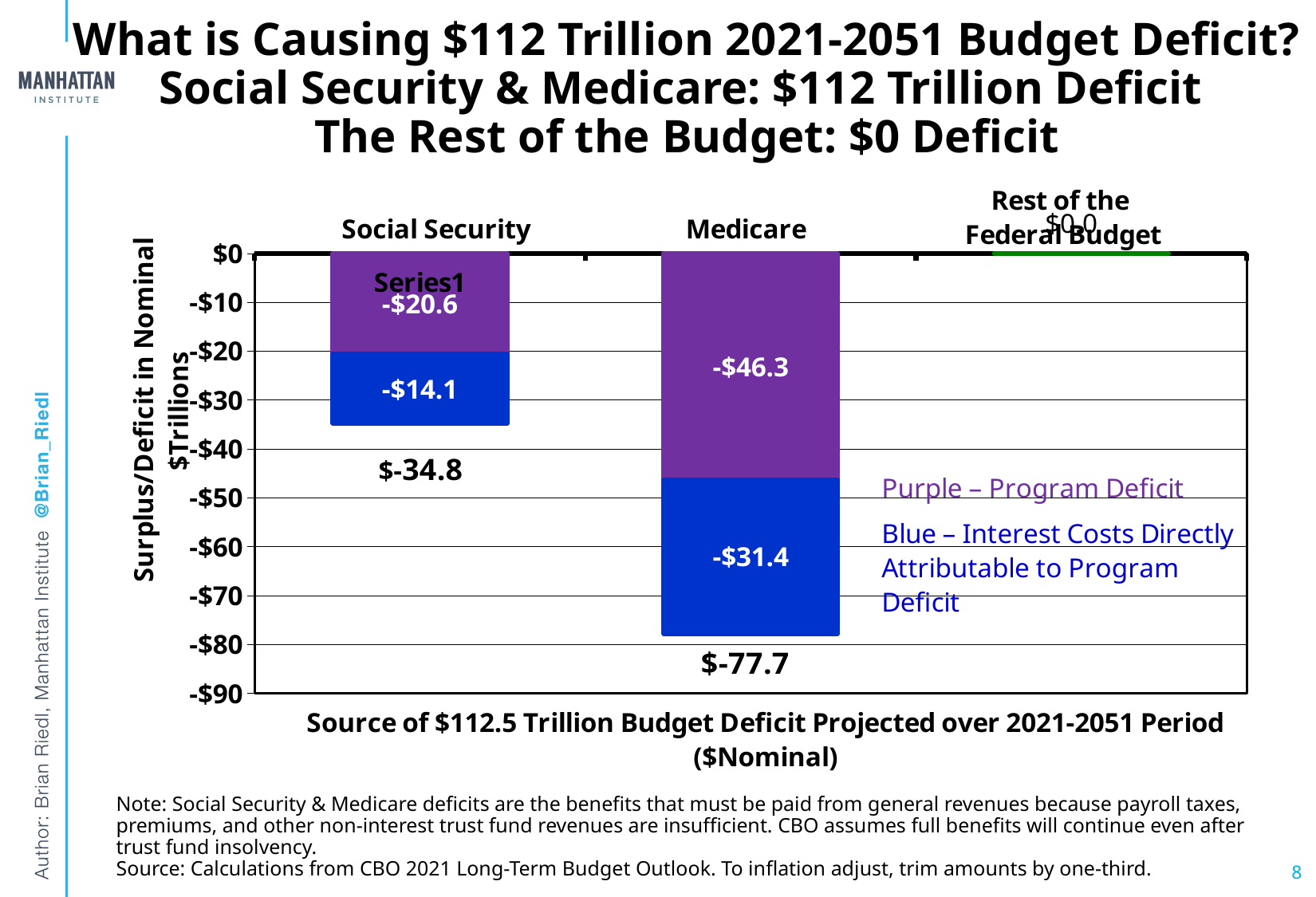
What is the program deficit (purple segment) value for Social Security? -$20.6 What is the interest cost (blue segment) value for Medicare? -$31.4 How many categories are shown on the x axis of the chart? 3 What is the program deficit (purple segment) value for Medicare? -$46.3 Which is larger in magnitude: the Medicare interest cost or the Social Security interest cost? Medicare interest cost What type of chart is shown on the slide? Stacked bar chart What is the total value labeled for the Medicare bar? $-77.7 What is the total value labeled for the Social Security bar? $-34.8 Which category has the largest deficit (most negative total)? Medicare What is the interest cost (blue segment) value for Social Security? -$14.1 What value is shown for Rest of the Federal Budget? $0.0 What is the difference between the Medicare program deficit (-$46.3) and the Social Security program deficit (-$20.6)? $25.7